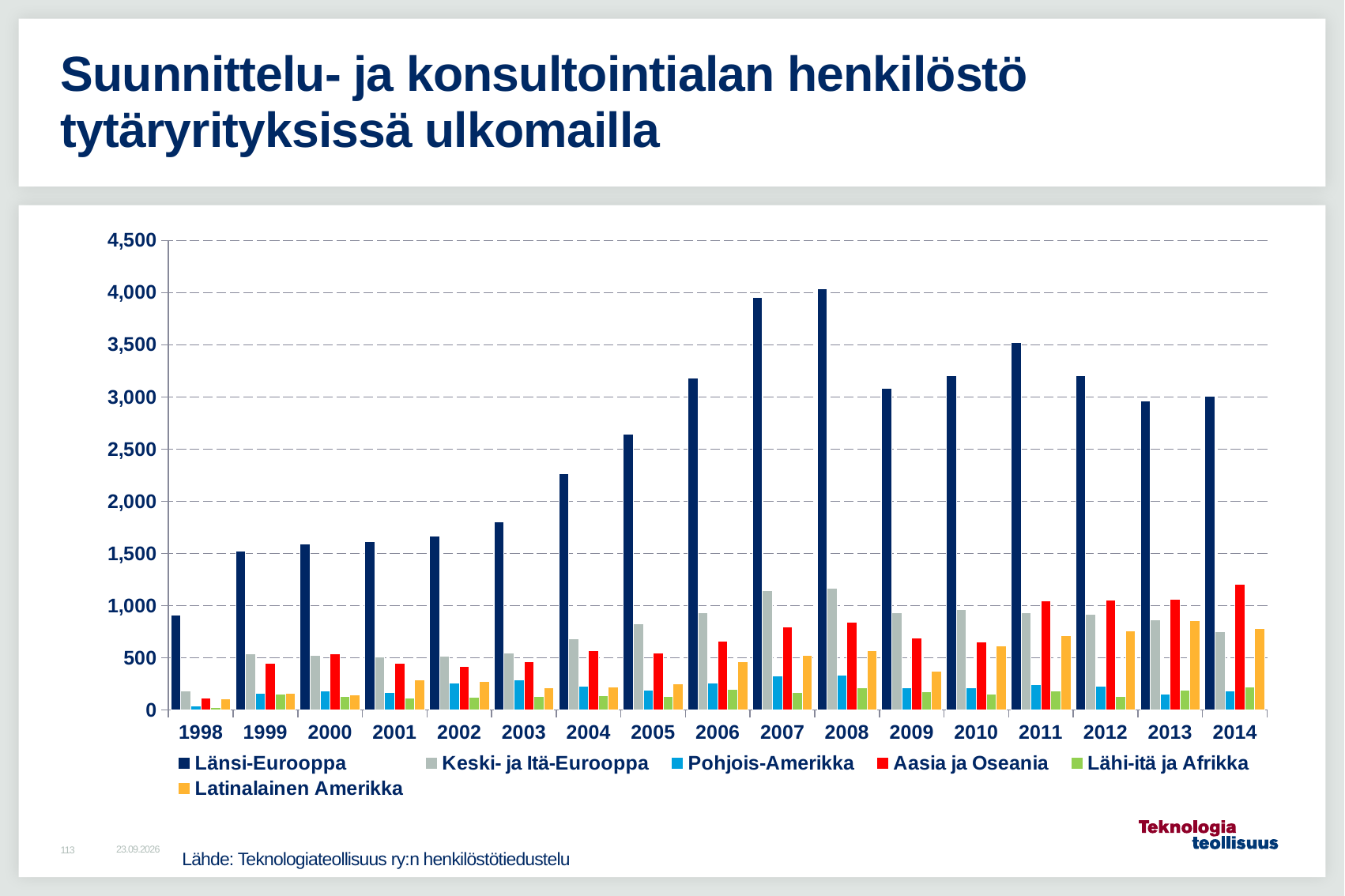
In which year is the Aasia ja Oseania value highest? 2014 In which year is the Latinalainen Amerikka value highest? 2013 Which year has the larger Länsi-Eurooppa value: 2010 or 2011? 2011 Is the value for Länsi-Eurooppa in 2007 greater or less than 3,500? greater Is the value for Länsi-Eurooppa in 1998 greater or less than 1,000? less Which is larger in 2014: Aasia ja Oseania or Keski- ja Itä-Eurooppa? Aasia ja Oseania Does the Länsi-Eurooppa value rise or fall from 1998 to 2008? rise In which year is the Länsi-Eurooppa value lowest? 1998 What kind of chart is shown on the slide? Bar chart How many years are shown on the x axis? 17 Is the value for Aasia ja Oseania in 2014 greater or less than 1,000? greater How many series does the legend list? 6